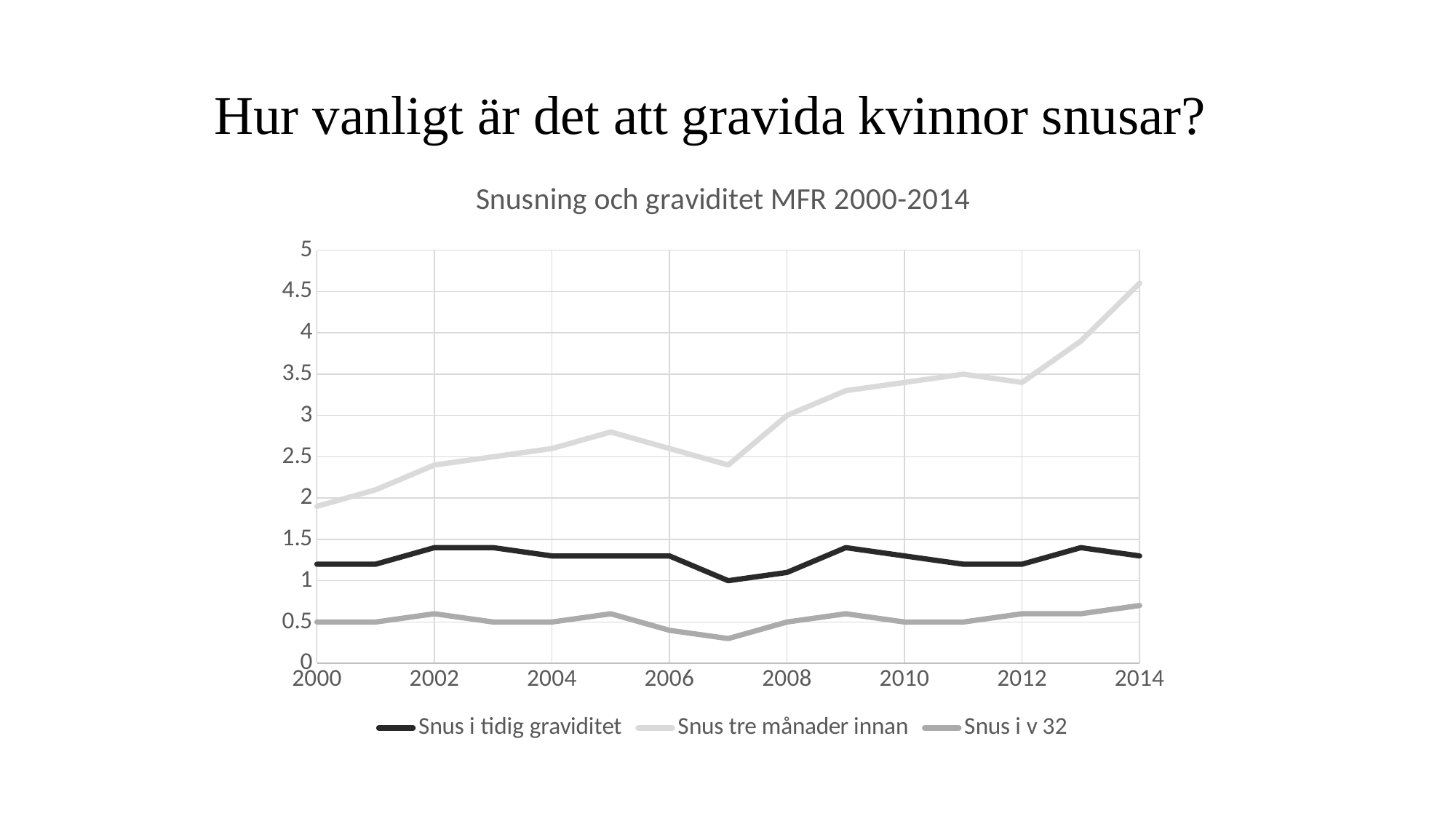
Is the value for Snus tre månader innan in 2014 greater or less than 4? greater Which series is shown with the darkest (black) line? Snus i tidig graviditet Does the value for Snus tre månader innan rise or fall from 2008 to 2014? rise Is the value for Snus i tidig graviditet in 2003 greater or less than 1? greater Which series has the highest value in 2014? Snus tre månader innan How many years are plotted along the x axis? 15 What kind of chart is shown on the slide? line chart How many series does the legend list? 3 Is the value for Snus i v 32 in 2007 greater or less than 0.5? less What is the title of the chart? Snusning och graviditet MFR 2000-2014 Which series has the lowest values across all years? Snus i v 32